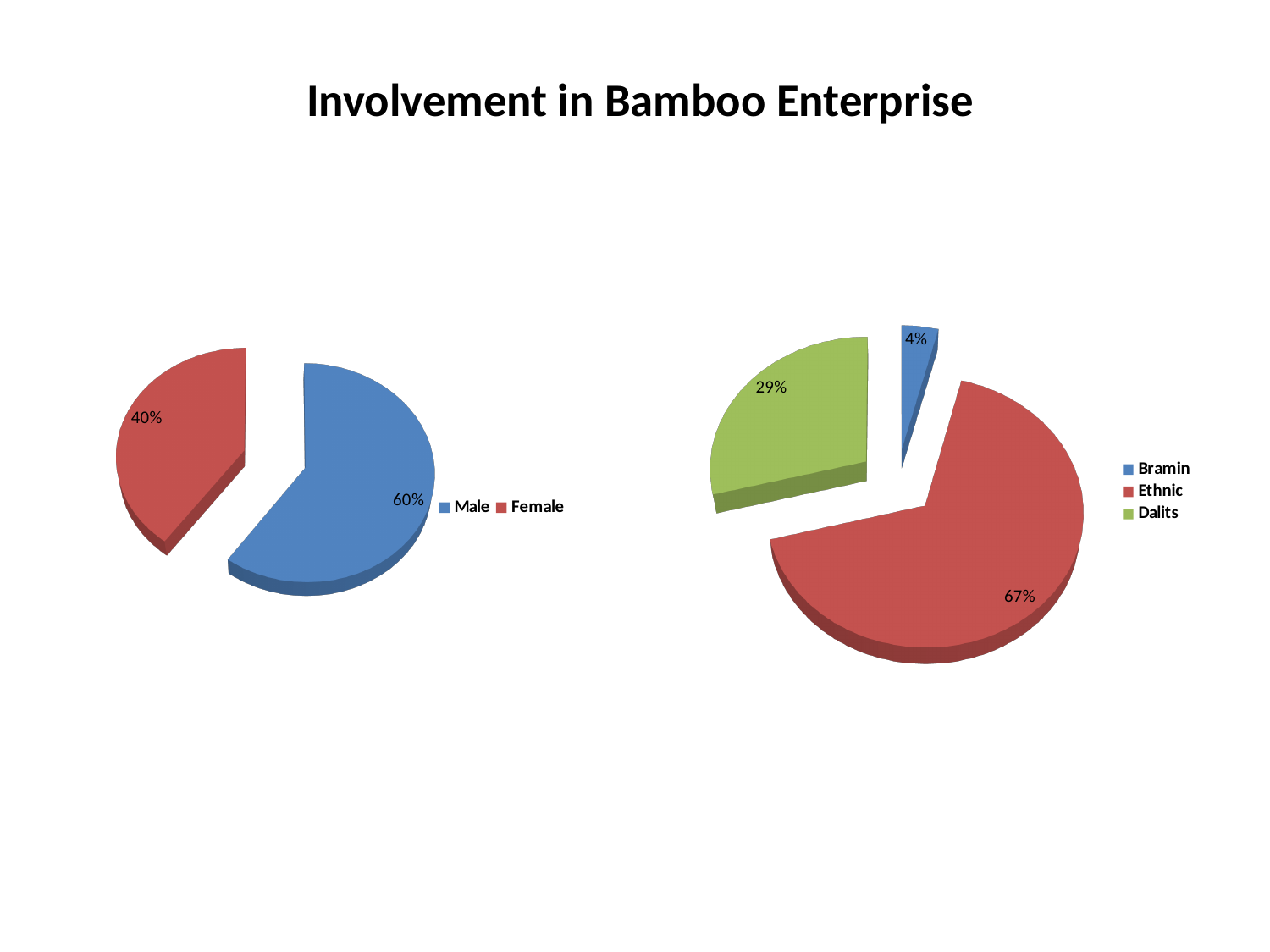
What is the title of the slide? Involvement in Bamboo Enterprise On the right pie chart, what share is labelled for Dalits? 29% On the right pie chart, which category has the smallest share? Bramin On the left pie chart, what share is labelled for Female? 40% On the right pie chart, what share is labelled for Ethnic? 67% On the left pie chart, which category has the larger share, Male or Female? Male On the left pie chart, what is the difference in percentage points between the Male and Female shares? 20 percentage points On the left pie chart, what share is labelled for Male? 60% On the right pie chart, how many categories does the legend list? 3 What type of chart is shown on the left of the slide? Pie chart On the right pie chart, which category has the largest share? Ethnic On the right pie chart, what share is labelled for Bramin? 4%